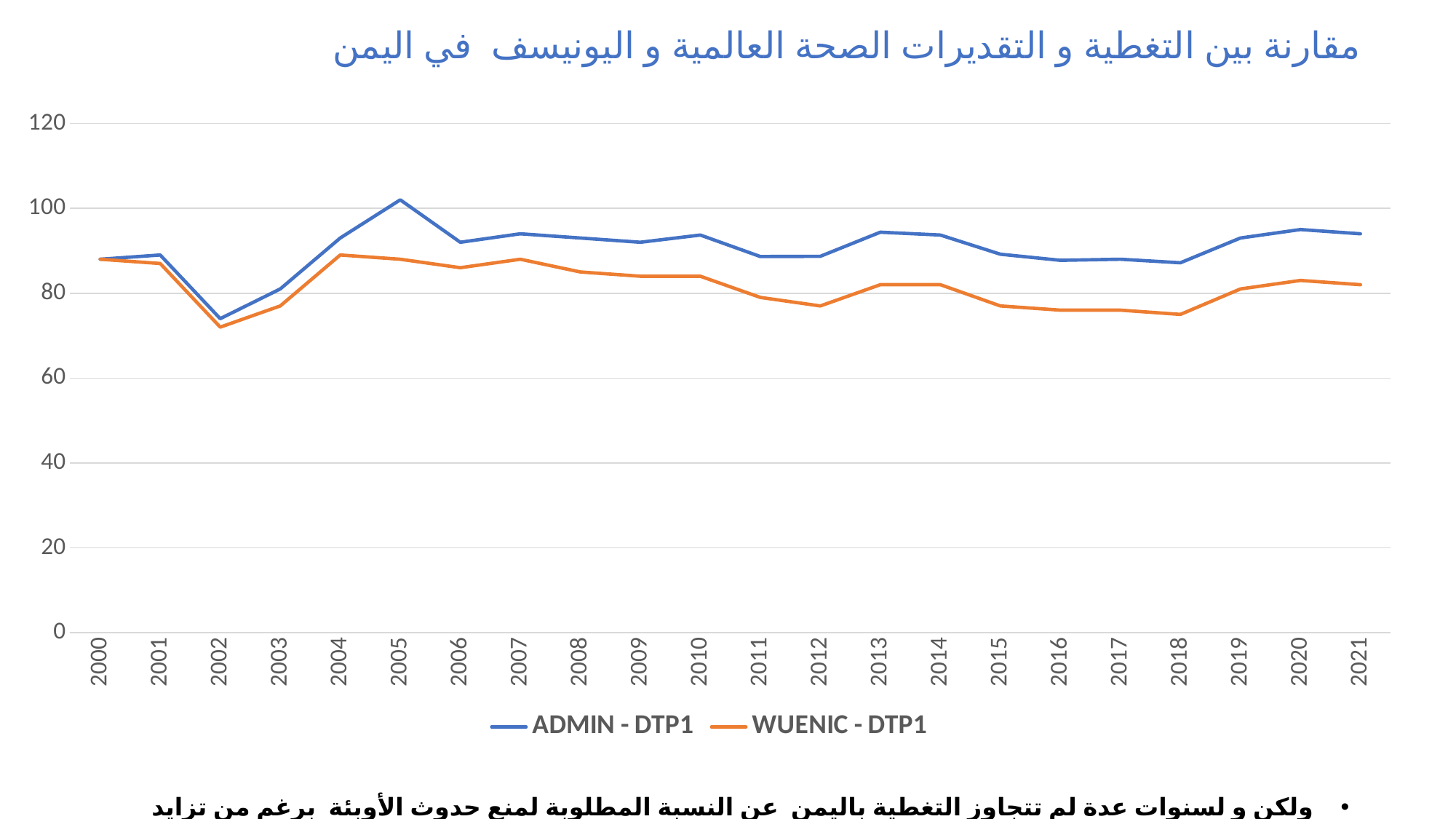
In which year does the WUENIC - DTP1 series reach its lowest value? 2002 Does the ADMIN - DTP1 series rise or fall from 2000 to 2002? fall How many years are plotted along the x axis? 22 In 2005, which series has the larger value, ADMIN - DTP1 or WUENIC - DTP1? ADMIN - DTP1 In which year does the ADMIN - DTP1 series reach its highest value? 2005 How many series does the legend list? 2 Is the value for ADMIN - DTP1 in 2013 greater or less than 80? greater Is the value for WUENIC - DTP1 in 2018 greater or less than 80? less In which year does the ADMIN - DTP1 series reach its lowest value? 2002 Is the value for WUENIC - DTP1 in 2002 greater or less than 80? less What kind of chart is shown on the slide? line chart